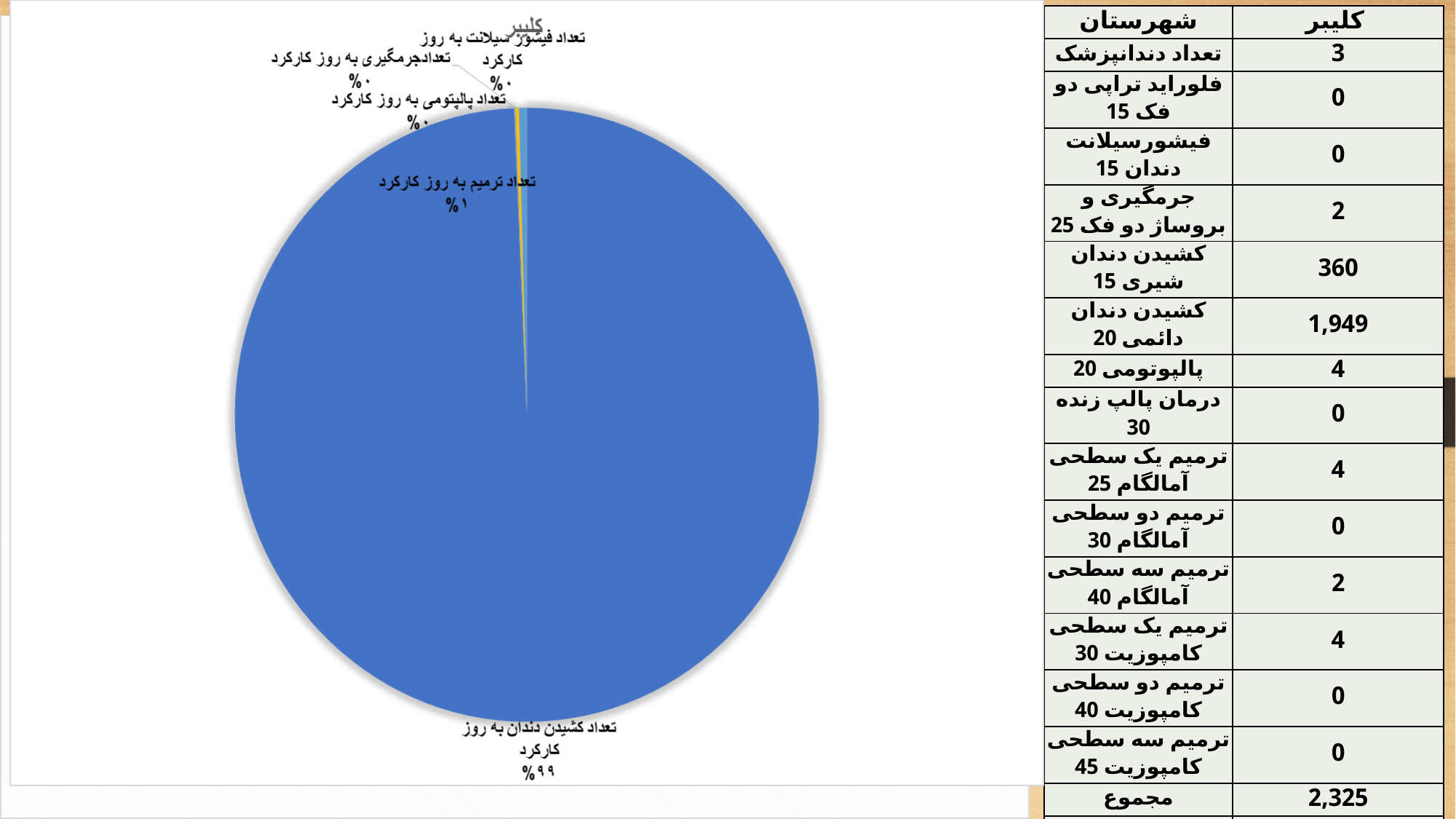
What is the title of the pie chart? کلیبر Which is larger: the share for تعداد کشیدن دندان به روز کارکرد or the share for تعداد ترمیم به روز کارکرد? تعداد کشیدن دندان به روز کارکرد What percentage is shown for تعداد ترمیم به روز کارکرد? ۱% What percentage is shown for تعداد پالپتومی به روز کارکرد? ۰% What percentage is shown for تعدادجرمگیری به روز کارکرد? ۰% What kind of chart is shown on the slide? pie chart What percentage is shown for تعداد کشیدن دندان به روز کارکرد? ۹۹% How many slices does the pie chart have? 5 Which category has the largest share of the pie chart? تعداد کشیدن دندان به روز کارکرد What is the difference in percentage points between تعداد کشیدن دندان به روز کارکرد and تعداد ترمیم به روز کارکرد? ۹۸% What percentage is shown for تعداد فیشور سیلانت به روز کارکرد? ۰% What colour is the largest slice of the pie chart? blue